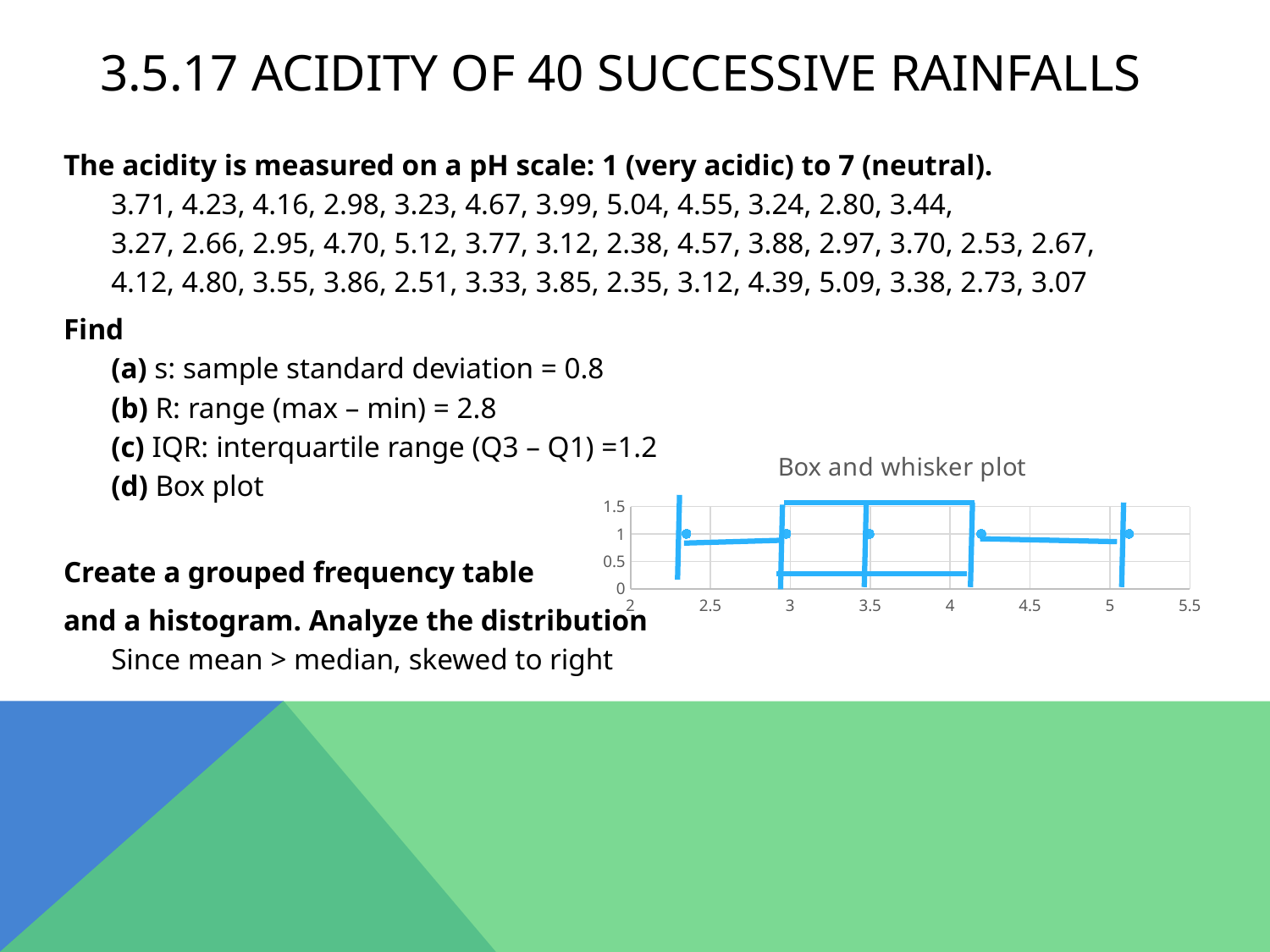
Is the median line inside the box greater or less than 3? greater Is the left edge of the box in the box plot greater or less than 2.5? greater Is the left end of the lower whisker in the box plot greater or less than 2.5? less What is the lowest value labelled on the horizontal axis of the box plot? 2 What is the title of the chart on the slide? Box and whisker plot What kind of chart is shown on the slide? Box and whisker plot How many tick labels are shown on the horizontal axis of the box plot? 8 Is the box plot drawn horizontally or vertically? horizontally What is the highest value labelled on the horizontal axis of the box plot? 5.5